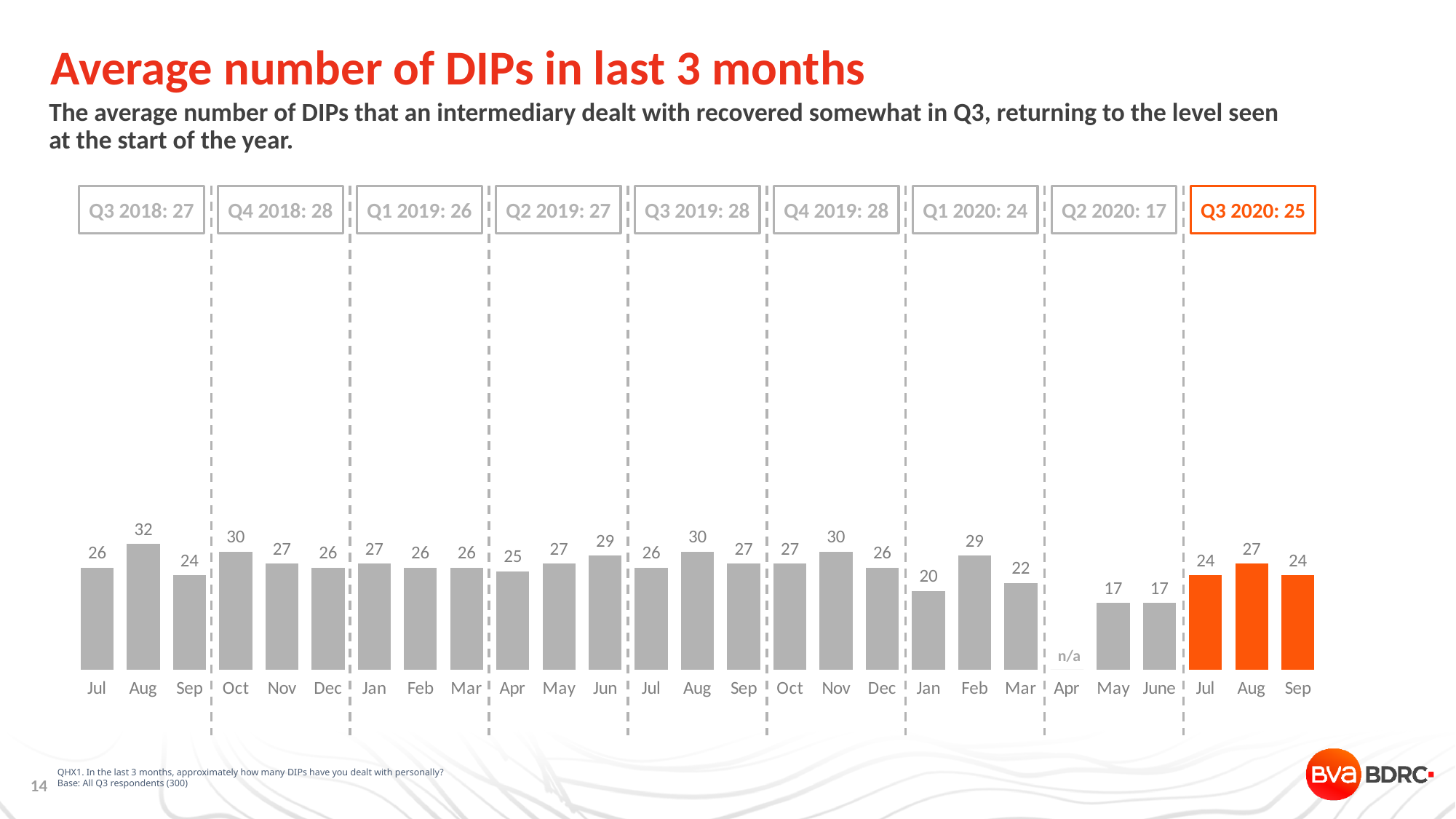
What is the value for Sep in the Q3 2020 section? 24 What is the difference between the Aug value in Q3 2020 and the Jul value in Q3 2020? 3 What is the value for Aug in the Q3 2018 section? 32 Which month has the highest bar in the chart? Aug (Q3 2018) What quarterly average is shown in the box for Q2 2020? 17 What is the value for Feb in the Q1 2020 section? 29 How many month categories are shown on the x axis? 27 Which is larger: the Nov value in Q4 2019 or the Dec value in Q4 2019? Nov What is the lowest plotted value in the chart? 17 What type of chart is shown on the slide? bar chart Which month is shown as n/a in the chart? Apr (Q2 2020) Which quarter's bars are coloured orange rather than grey? Q3 2020